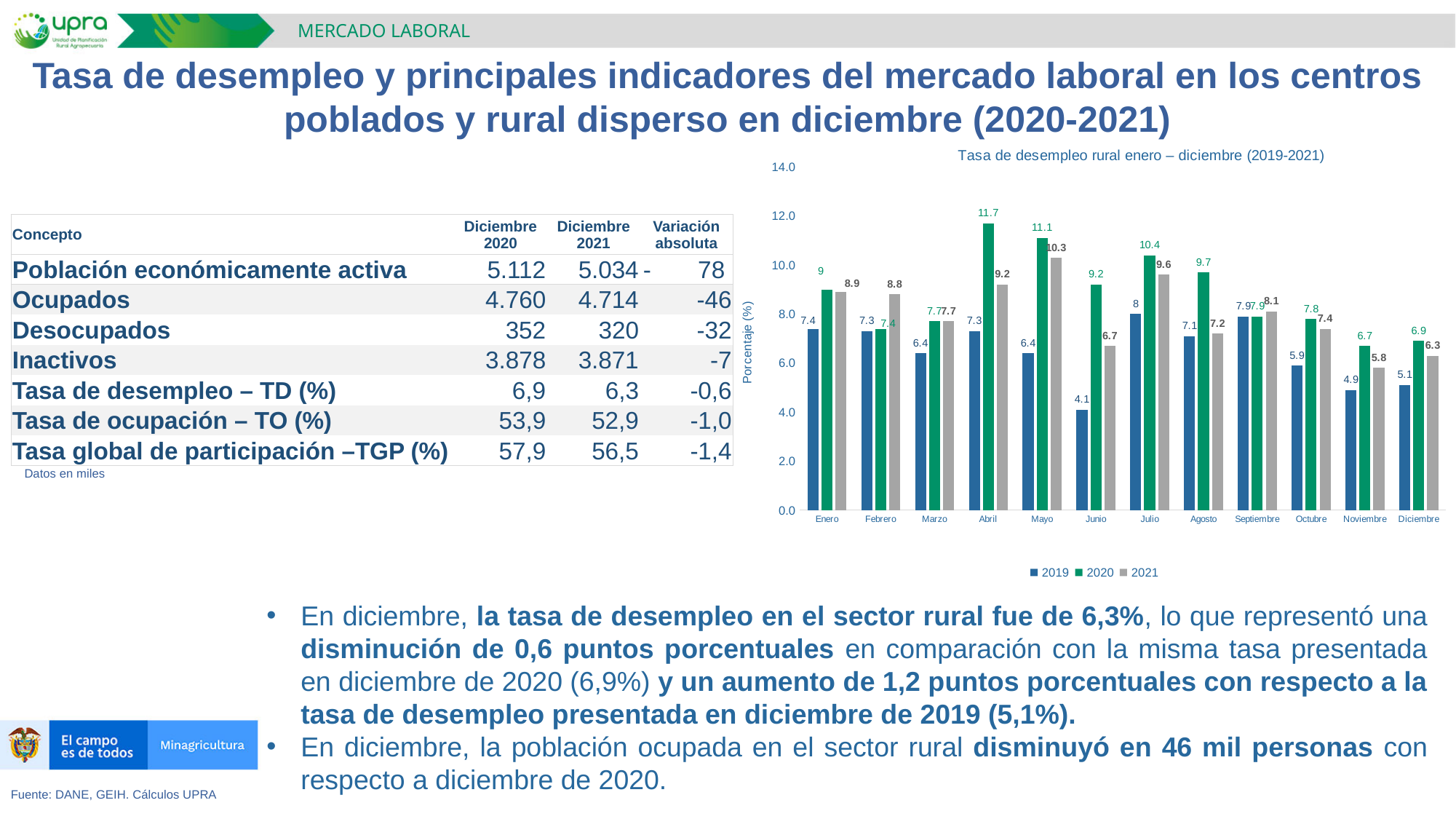
What is the rural unemployment rate for 2020 in Abril? 11.7 In which month is the 2019 series lowest? Junio What is the difference between the 2020 and 2019 values in Diciembre? 1.8 What is the title of the chart? Tasa de desempleo rural enero – diciembre (2019-2021) In which month is the 2020 series highest? Abril Which is larger in Febrero, the 2021 value or the 2019 value? 2021 What type of chart is shown on the slide? bar chart What is the value for 2021 in Mayo? 10.3 Is the value for 2020 in Mayo greater or less than 10.0? greater What is the value for 2019 in Junio? 4.1 How many months are shown on the x axis of the chart? 12 How many series does the chart legend list? 3